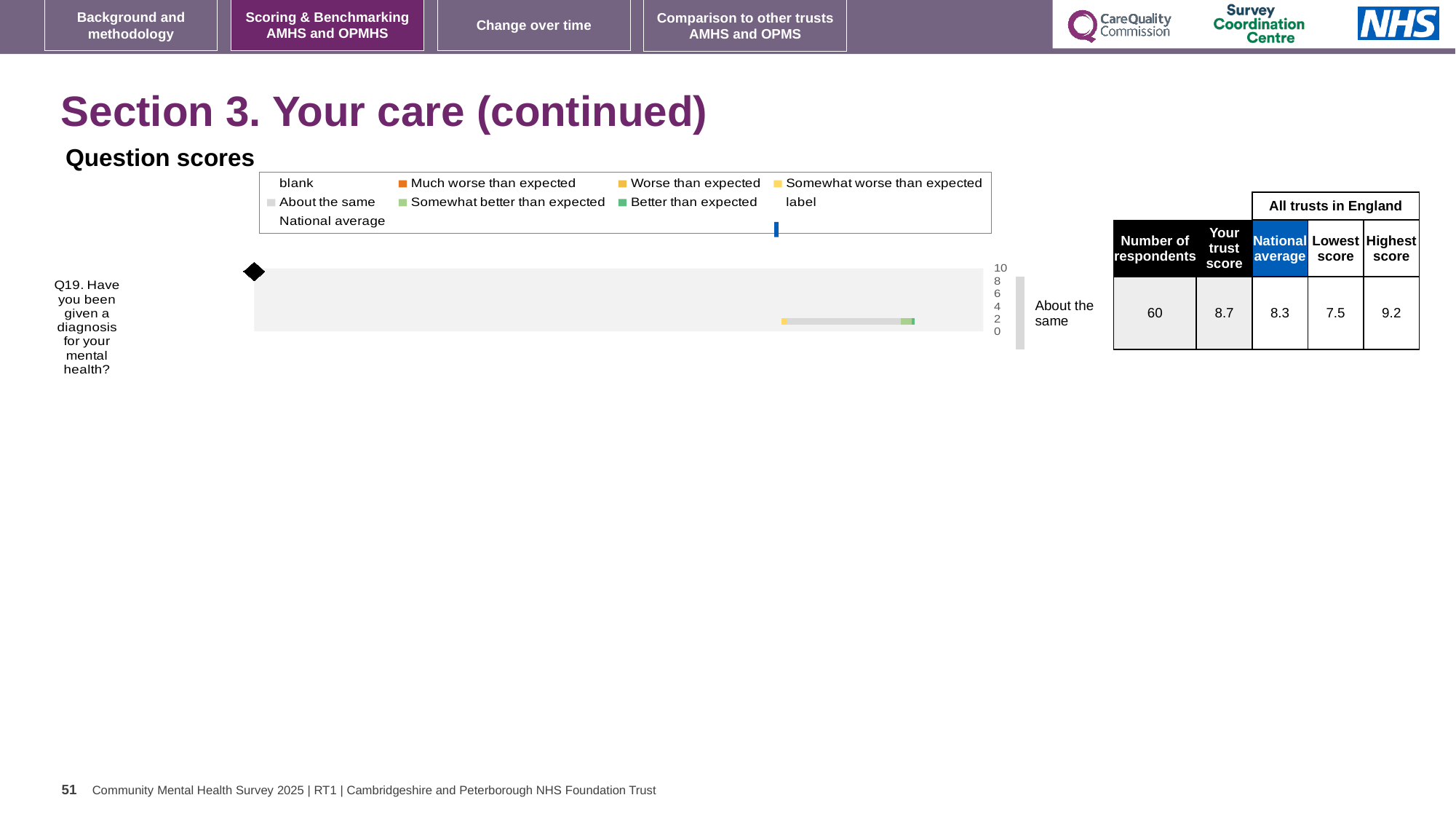
How many respondents answered Q19? 60 What is the trust's score for Q19? 8.7 What is the national average score for Q19? 8.3 What is the highest score among all trusts in England for Q19? 9.2 What is the difference between the trust's score and the national average for Q19? 0.4 What is the difference between the highest and lowest scores among all trusts in England for Q19? 1.7 Is the trust's score for Q19 higher or lower than the national average? higher How many survey questions are plotted in the Question scores chart? 1 Which question is plotted in the Question scores chart? Q19. Have you been given a diagnosis for your mental health? What is the lowest score among all trusts in England for Q19? 7.5 What benchmark category is the trust's Q19 score assigned to? About the same What kind of chart is shown under 'Question scores'? bar chart